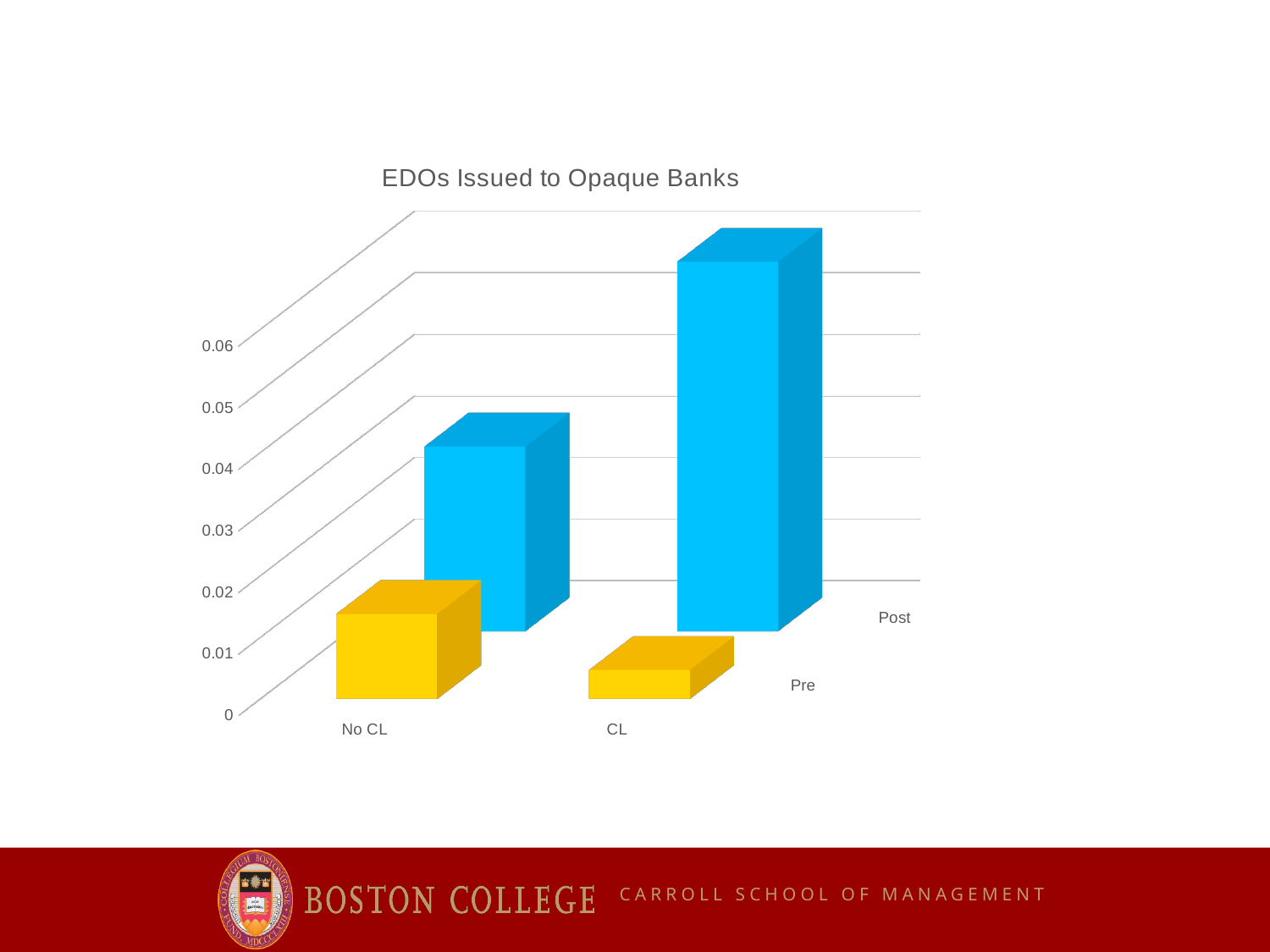
How many categories are shown on the x axis of the chart? 2 What is the title of the chart? EDOs Issued to Opaque Banks For No CL, which is larger, the Pre value or the Post value? Post For the Post series, which category has the larger value, No CL or CL? CL Which series is shown in yellow? Pre Which bar is the tallest in the chart? Post for CL How many series does the chart show? 2 Is the Post value for No CL greater or less than 0.04? less Is the Pre value for CL greater or less than 0.01? less Which bar is the shortest in the chart? Pre for CL Is the Post value for CL greater or less than 0.04? greater What kind of chart is shown on the slide? Bar chart